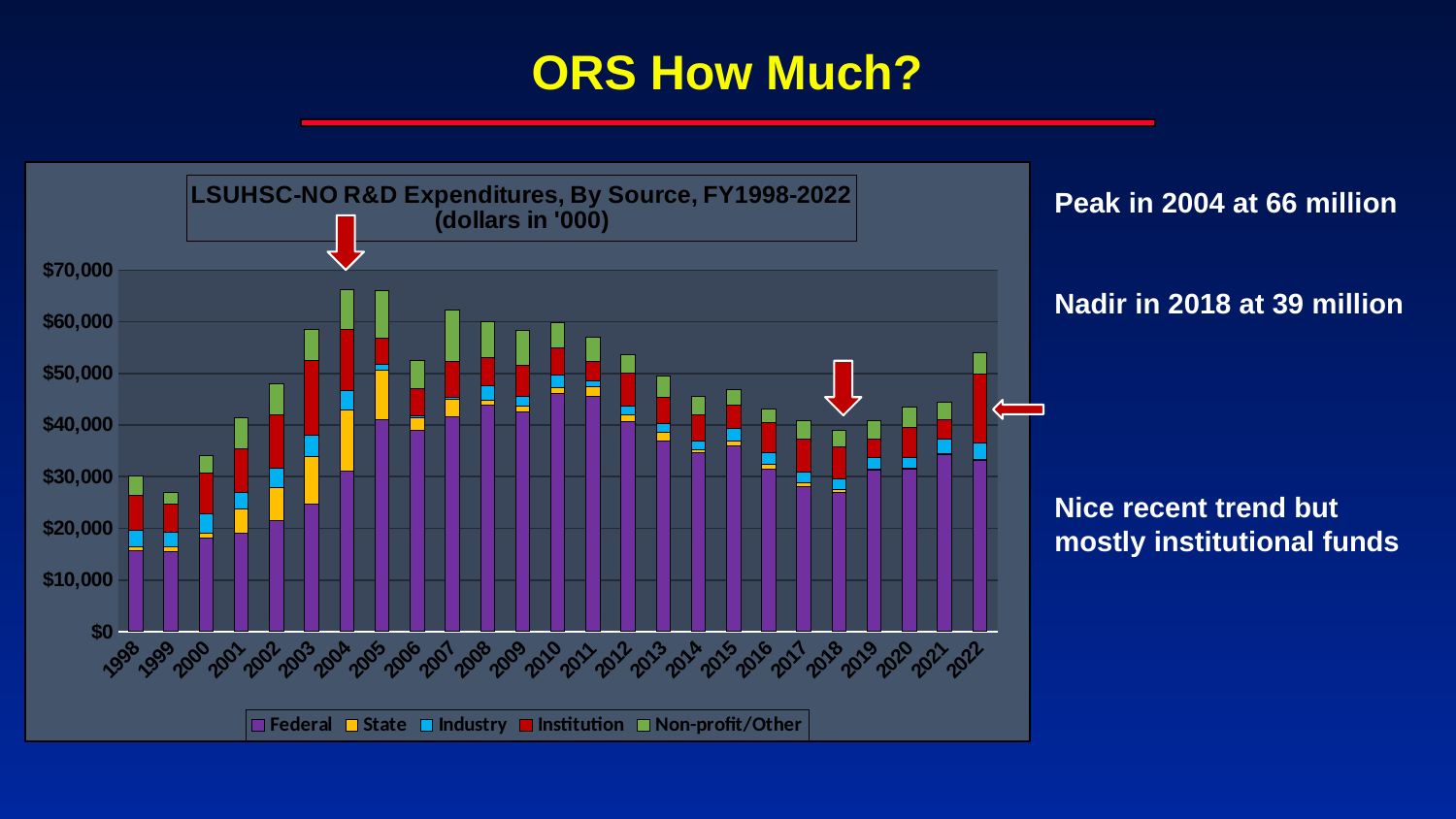
How many series does the chart's legend list? 5 Is the total bar for 2004 greater or less than $60,000? greater Is the total bar for 2017 greater or less than $50,000? less Which year has the larger total bar, 2004 or 2018? 2004 Is the total bar for 2022 greater or less than $50,000? greater Do the total bars generally rise or fall from 2004 to 2018? fall How many fiscal years are plotted along the x axis of the chart? 25 What is the title of the chart? LSUHSC-NO R&D Expenditures, By Source, FY1998-2022 (dollars in '000) Which fiscal year has the tallest total bar in the chart? 2004 What kind of chart is shown on the slide? Stacked bar chart Which colour represents the Federal series in the chart? Purple